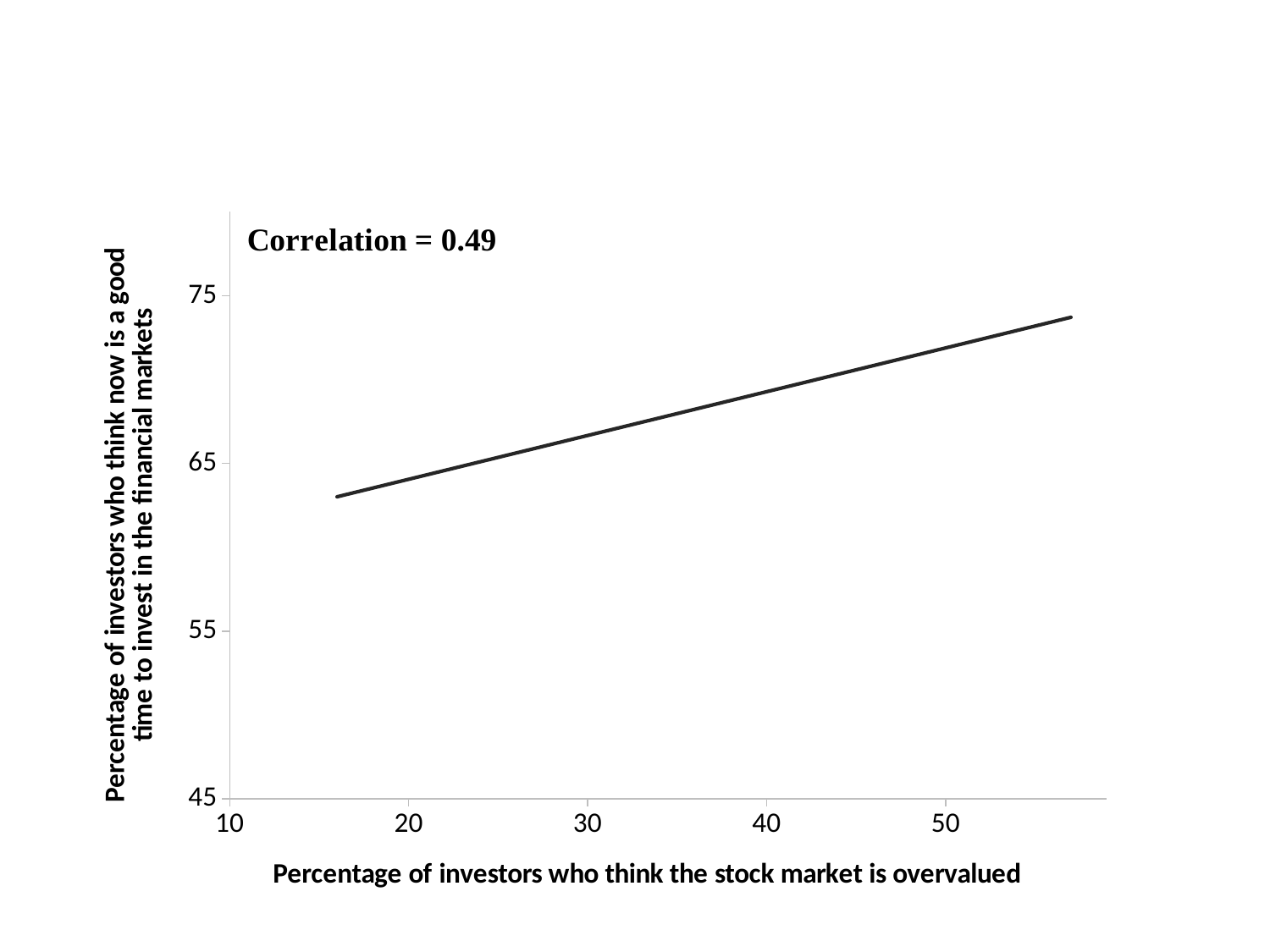
Where the horizontal axis value is 20, is the line's value greater or less than 75? less Where the horizontal axis value is 20, is the line's value greater or less than 55? greater What correlation value is printed on the chart? Correlation = 0.49 Is the line's value higher at a horizontal axis value of 50 or at 20? 50 Does the line rise or fall as the percentage of investors who think the stock market is overvalued increases? Rises Where the horizontal axis value is 40, is the line's value greater or less than 65? greater What is the label of the horizontal axis? Percentage of investors who think the stock market is overvalued How many lines are plotted on the chart? 1 What kind of chart is shown on the slide? Line chart